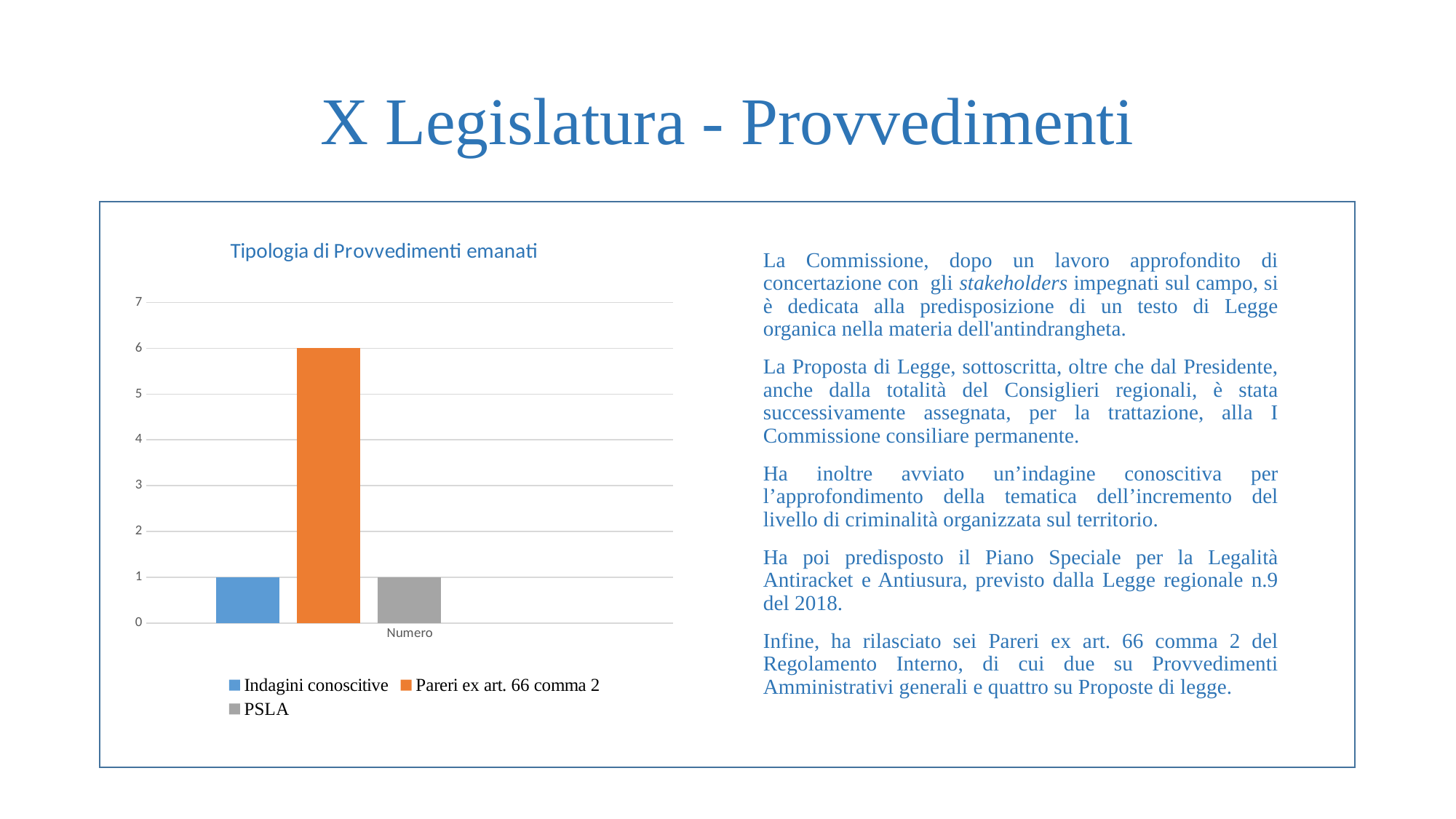
What is the title of the chart? Tipologia di Provvedimenti emanati How many series does the chart legend list? 3 What is the total of the three values shown in the chart? 8 What is the value for Indagini conoscitive? 1 What is the value for PSLA? 1 Which series has the highest value? Pareri ex art. 66 comma 2 Is the value for Pareri ex art. 66 comma 2 greater or less than 4? greater What is the difference between the value for Pareri ex art. 66 comma 2 and the value for PSLA? 5 What is the value for Pareri ex art. 66 comma 2? 6 What is the label of the category on the x axis? Numero Which is larger, the value for Pareri ex art. 66 comma 2 or the value for Indagini conoscitive? Pareri ex art. 66 comma 2 What kind of chart is shown on the slide? bar chart